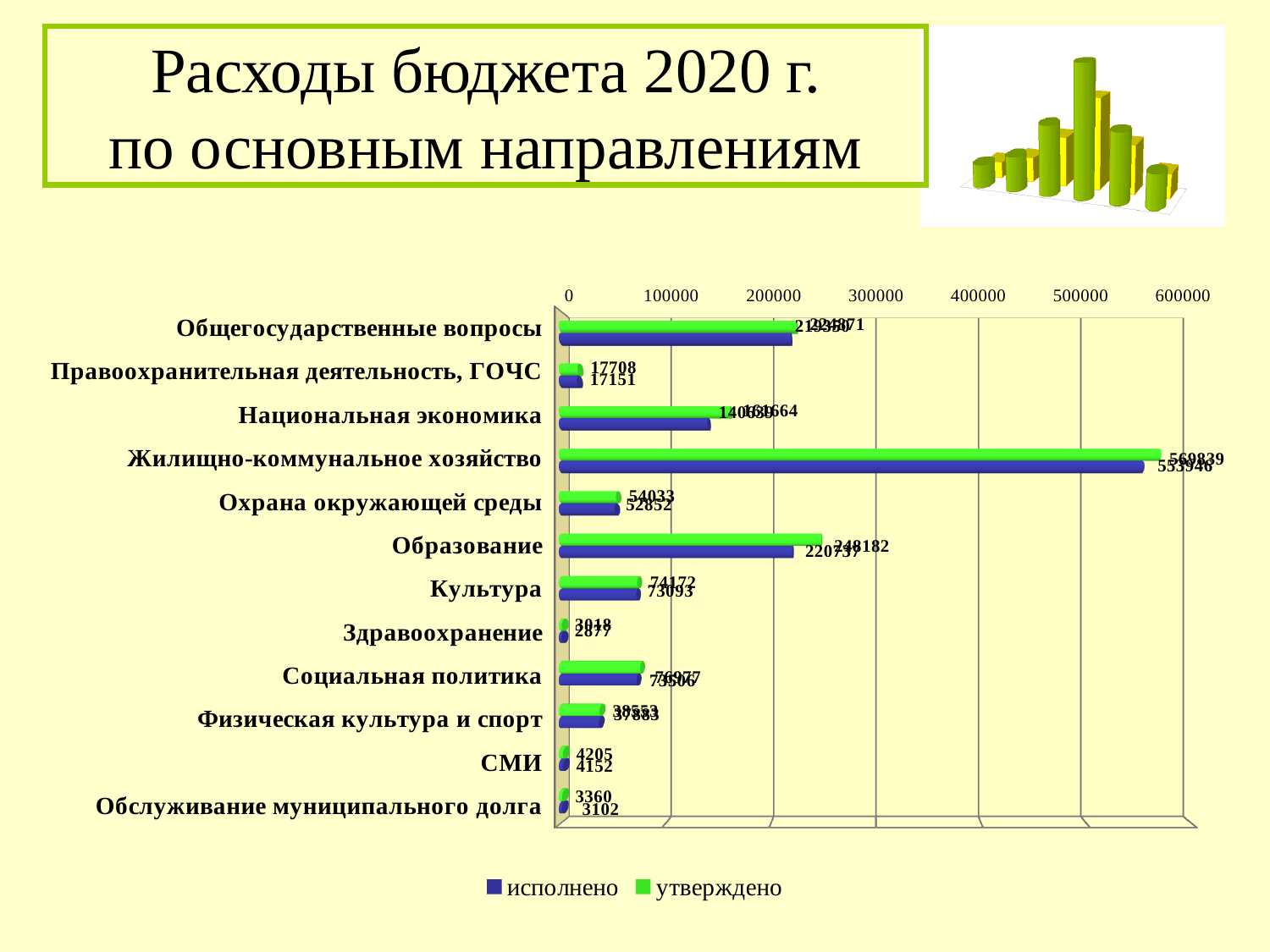
What is the утверждено value for Охрана окружающей среды? 54033 How many series does the legend list? 2 What is the исполнено value for СМИ? 4152 How many categories are shown on the chart? 12 What is the исполнено value for Образование? 220737 What is the утверждено value for Правоохранительная деятельность, ГОЧС? 17708 What are the two series named in the legend? исполнено, утверждено Is the исполнено value for Жилищно-коммунальное хозяйство greater or less than 500000? greater What kind of chart is shown on the slide? bar chart Which has a larger утверждено value, Образование or Культура? Образование Which category has the highest values on the chart? Жилищно-коммунальное хозяйство What is the difference between the утверждено and исполнено values for Образование? 27445